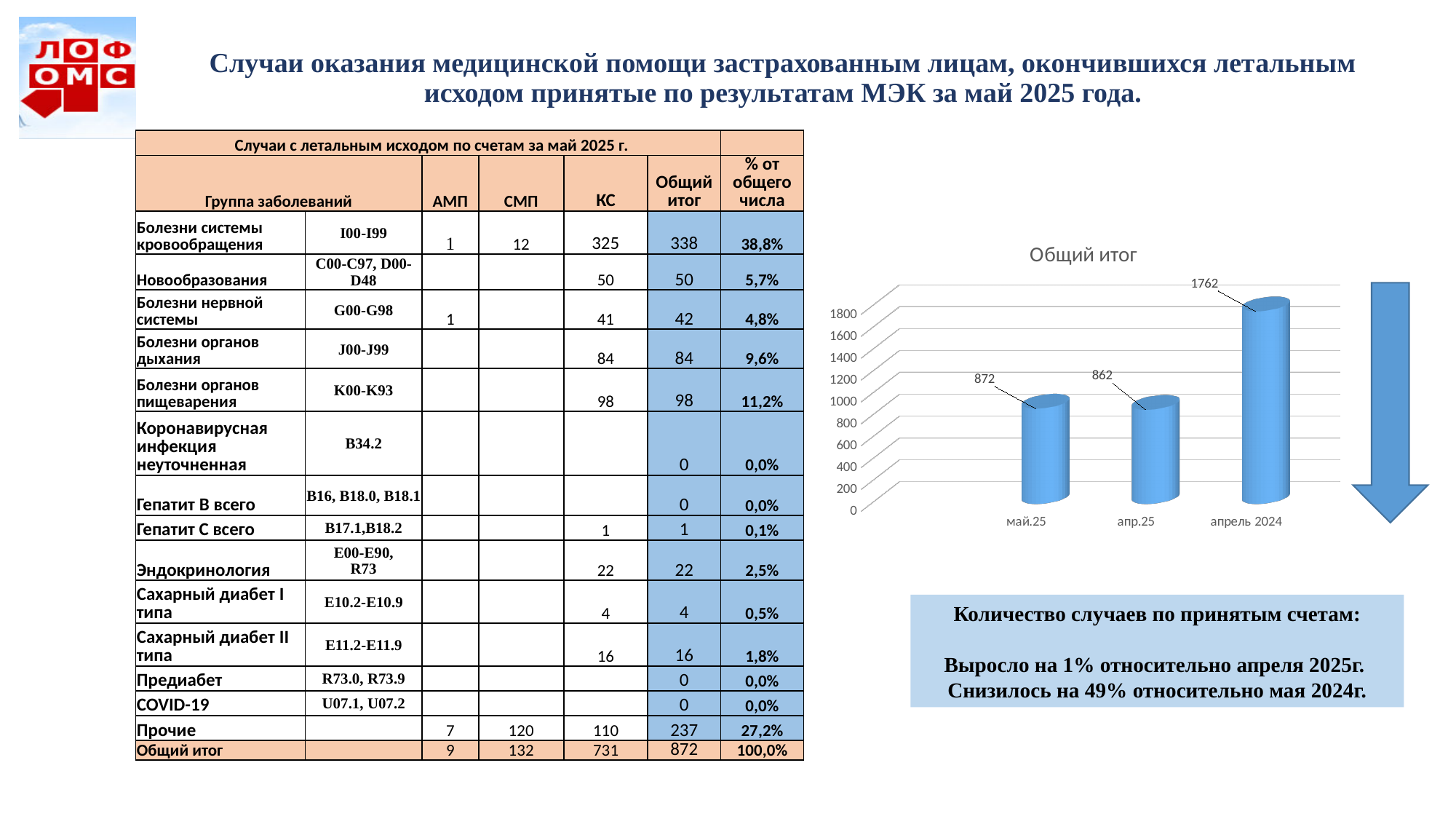
Which is larger in the chart titled "Общий итог": the value for апрель 2024 or the value for апр.25? апрель 2024 How many categories are shown on the x axis of the chart titled "Общий итог"? 3 What is the difference between the values for апрель 2024 and май.25 in the chart titled "Общий итог"? 890 What kind of chart is the chart titled "Общий итог"? bar chart What is the value for апрель 2024 in the chart titled "Общий итог"? 1762 What is the value for апр.25 in the chart titled "Общий итог"? 862 What is the value for май.25 in the chart titled "Общий итог"? 872 Is the value for апрель 2024 in the chart titled "Общий итог" greater or less than 1600? greater What is the difference between the values for май.25 and апр.25 in the chart titled "Общий итог"? 10 What is the title of the chart on the right side of the slide? Общий итог Which category has the highest value in the chart titled "Общий итог"? апрель 2024 Is the value for май.25 in the chart titled "Общий итог" greater or less than 1000? less